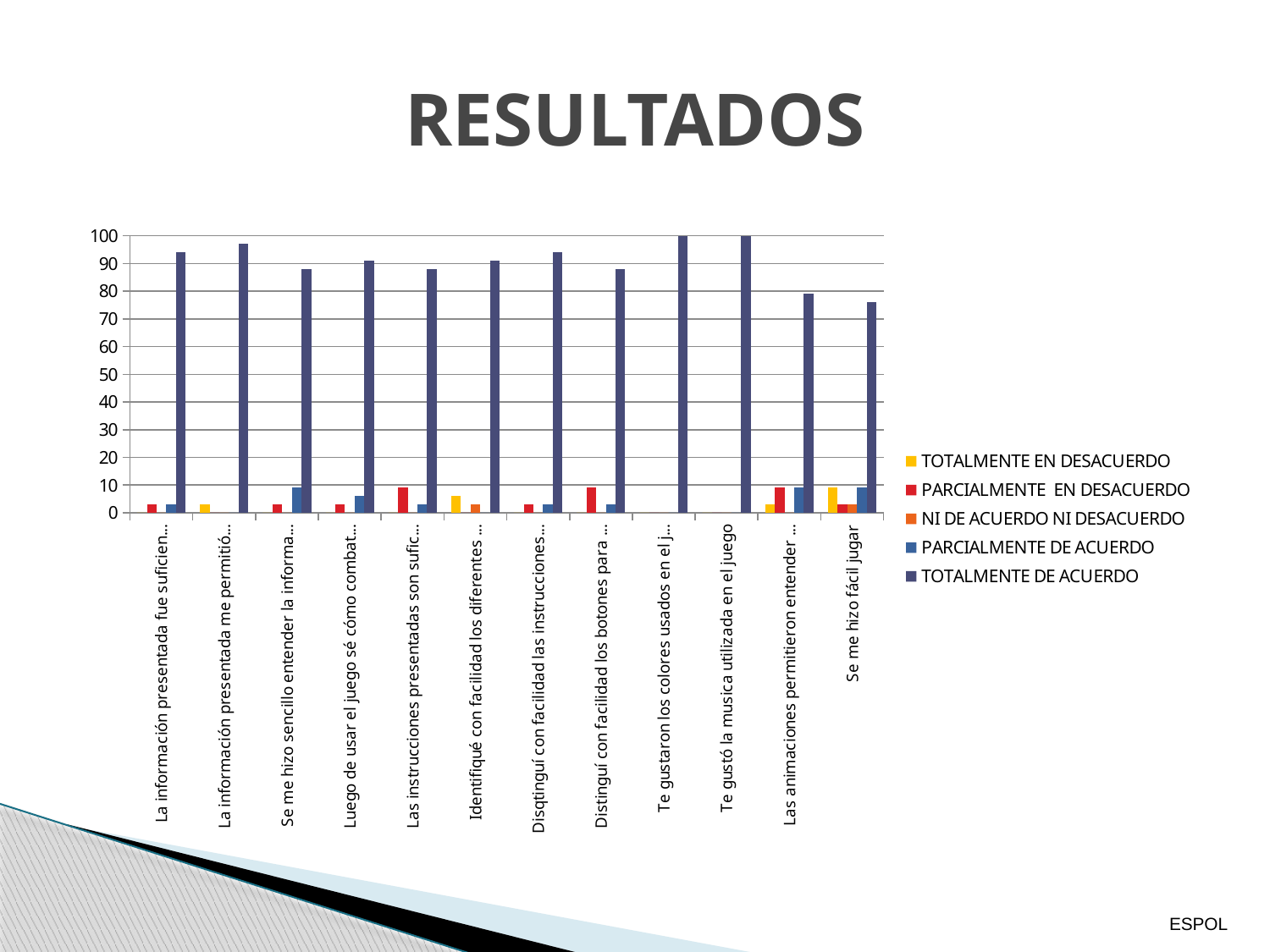
How many categories are shown along the x axis? 12 Is the TOTALMENTE DE ACUERDO value for "Se me hizo fácil jugar" greater or less than 80? less What kind of chart is shown on the slide? bar chart What is the TOTALMENTE DE ACUERDO value for "Te gustó la musica utilizada en el juego"? 100 What is the title of the slide? RESULTADOS How many series does the legend list? 5 Is the TOTALMENTE DE ACUERDO value for "La información presentada me permitió..." greater or less than 90? greater Which series is shown in yellow in the legend? TOTALMENTE EN DESACUERDO Which is larger, the TOTALMENTE DE ACUERDO value for "La información presentada me permitió..." or for "Se me hizo fácil jugar"? La información presentada me permitió... Which series has the tallest bars in every category? TOTALMENTE DE ACUERDO